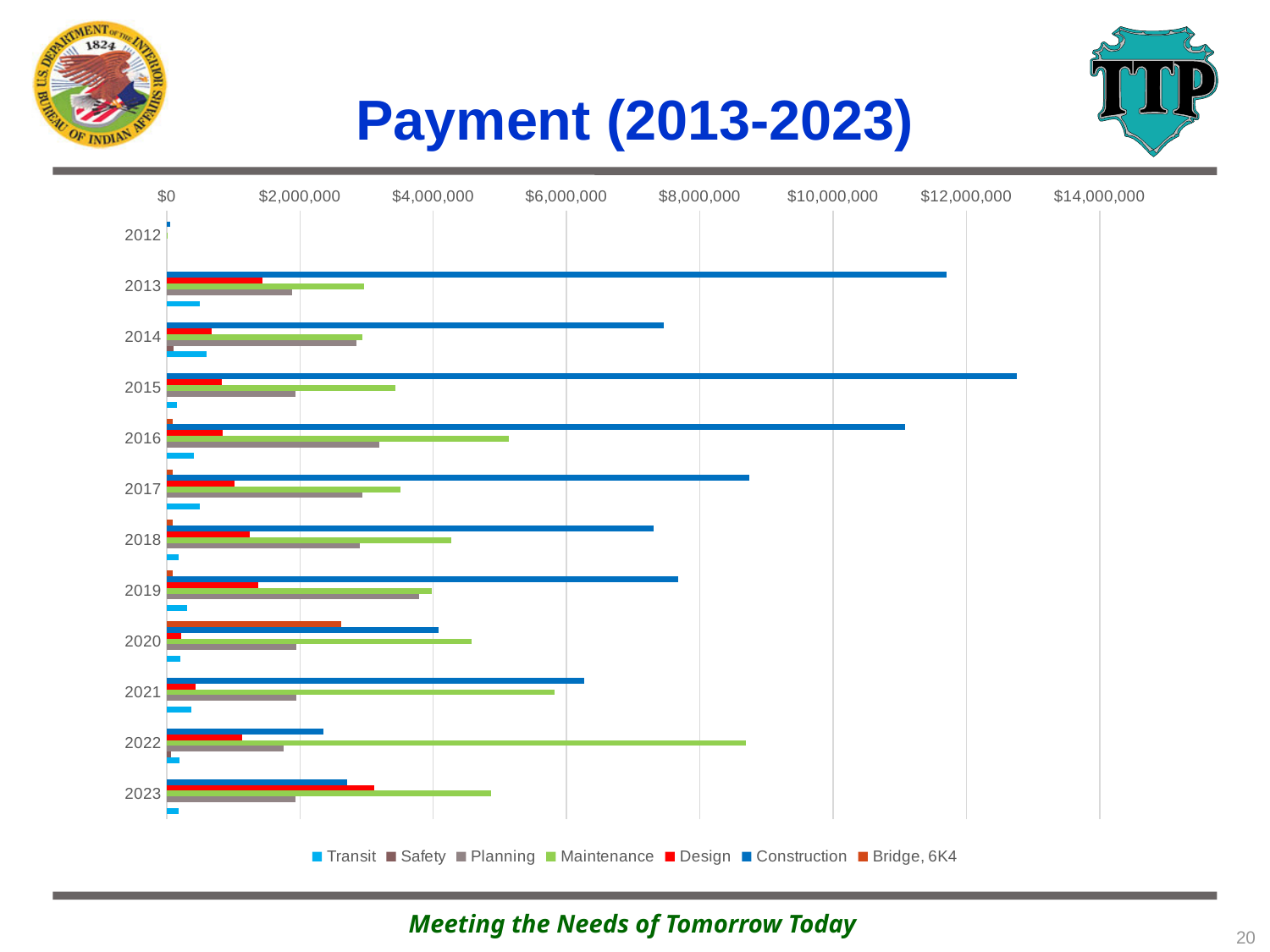
Is the Construction value for 2015 greater or less than $12,000,000? greater What kind of chart is shown on the slide? bar chart Is the Construction value for 2022 greater or less than $4,000,000? less In which year is the Construction value the highest? 2015 Is the Construction value for 2016 greater or less than $10,000,000? greater Which is larger in 2022, the Maintenance value or the Construction value? Maintenance How many series does the legend list? 7 How many year categories are shown on the vertical axis? 12 Which year has the larger Construction value, 2017 or 2019? 2017 What is the title of the chart? Payment (2013-2023) In which year is the Maintenance value the highest? 2022